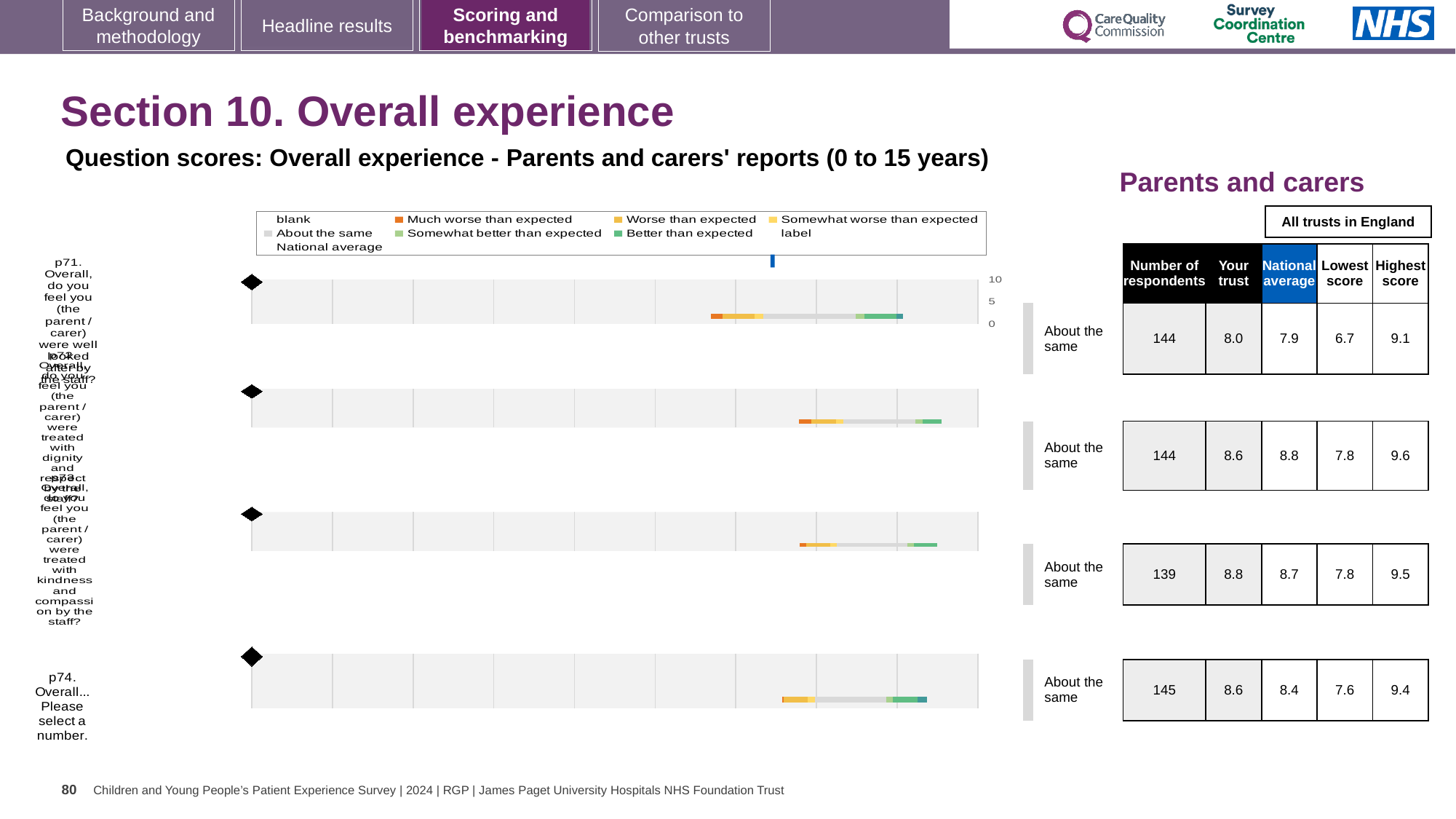
Which question has the highest 'Your trust' score in the table? p73 In the table next to the chart, what is the National average for p74 (Overall... Please select a number)? 8.4 In the table next to the chart, what is the 'Your trust' score for p71 (Overall, do you feel you were well looked after by the staff)? 8.0 For p72, which is larger: the 'Your trust' score or the National average? National average How many questions (rows) are plotted in the question scores chart? 4 What benchmark category is shown beside each of the four question bars? About the same In the table next to the chart, how many respondents answered p73? 139 Which question has the lowest 'Your trust' score in the table? p71 How many entries does the chart legend list? 9 What is the difference between the Highest score and the Lowest score for p71 in the table? 2.4 In the table next to the chart, what is the Highest score for p72? 9.6 What kind of chart is used to show the question scores on this slide? bar chart